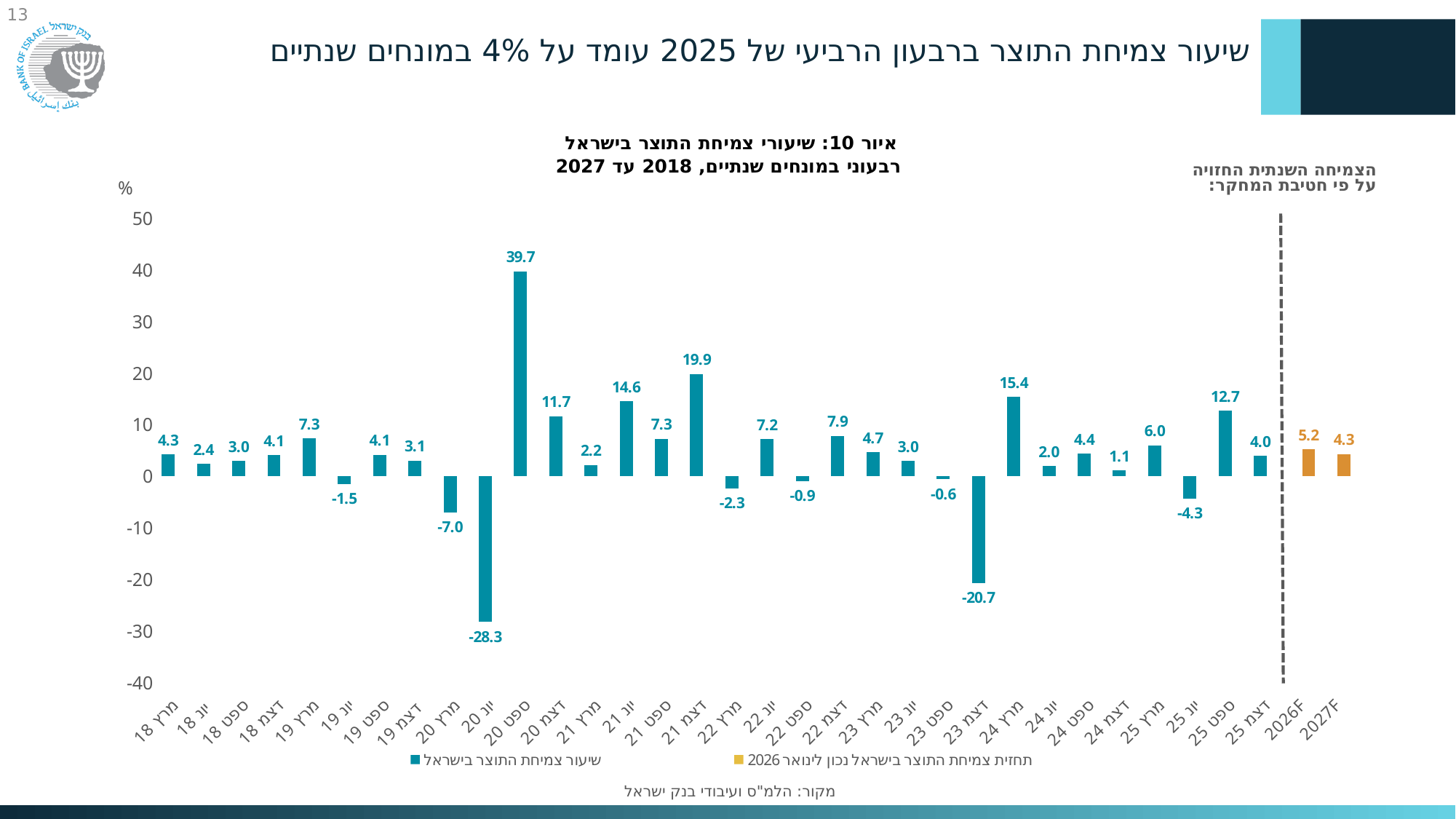
Which is larger, the value for דצמ 21 or the value for מרץ 24? דצמ 21 What is the value for the 2027F bar? 4.3 Is the value for דצמ 23 greater or less than -10? less Which quarter has the highest value? ספט 20 What is the value for ספט 20 (September 2020)? 39.7 What kind of chart is shown? bar chart What is the difference between the values for ספט 20 (39.7) and יונ 20 (-28.3)? 68.0 What is the value for דצמ 25 (December 2025)? 4.0 What is the value for the 2026F bar? 5.2 Which quarter has the lowest value? יונ 20 How many series does the legend list? 2 What colour are the forecast bars for 2026F and 2027F? orange